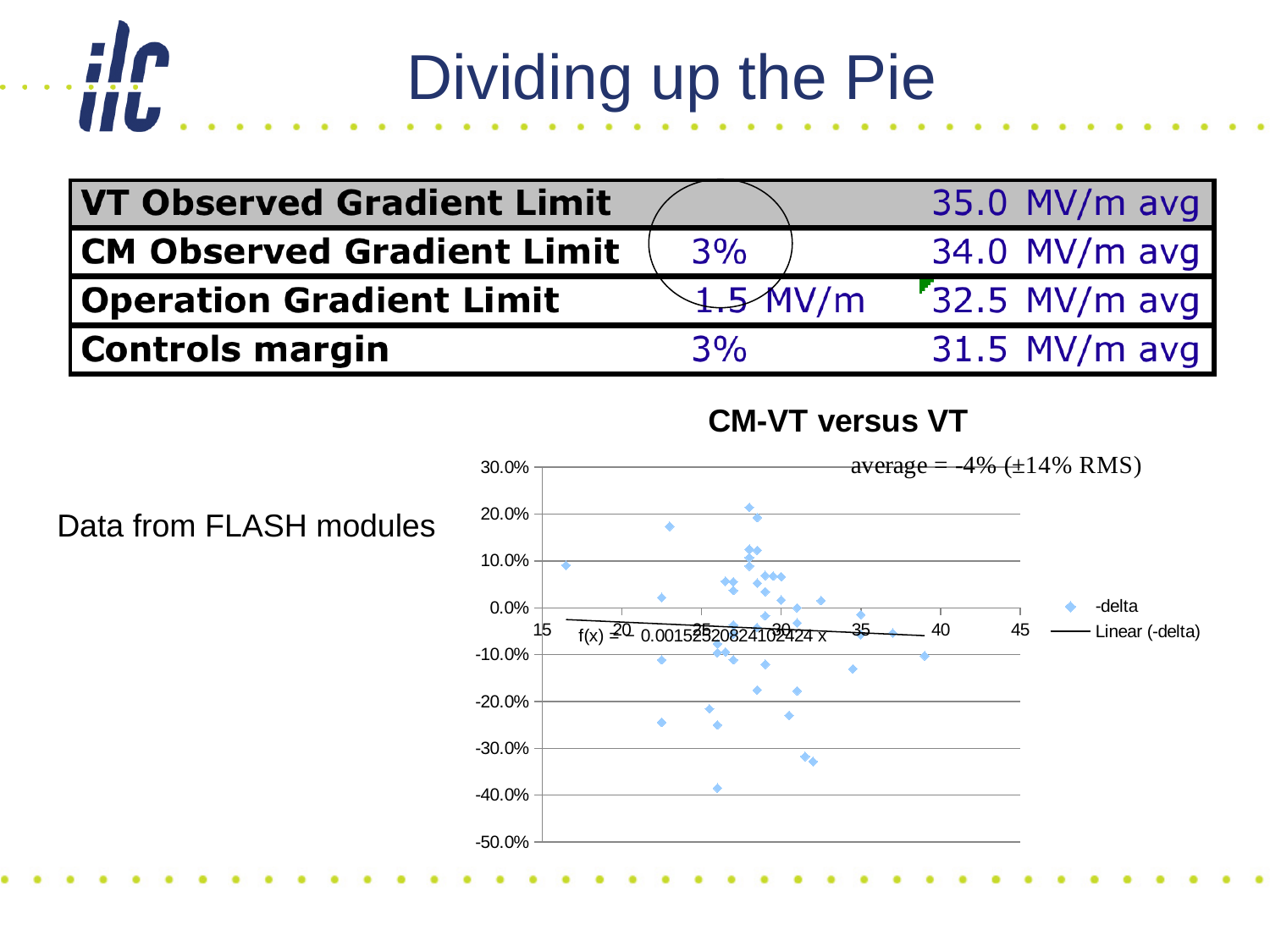
Does the linear trend line in the chart rise or fall as the x value increases? fall According to the annotation on the chart, what is the RMS spread of the plotted data? ±14% What are the two entries in the chart's legend? -delta and Linear (-delta) Is the highest plotted point in the chart greater or less than 10.0%? greater Is the lowest plotted point in the chart greater or less than -30.0%? less According to the annotation on the chart, what is the average value of the plotted data? -4% Is the plotted point with the smallest x value (near x = 16) greater or less than 0.0%? greater How many series does the chart's legend list? 2 What kind of chart is shown on the slide? scatter chart What is the title of the chart on the slide? CM-VT versus VT